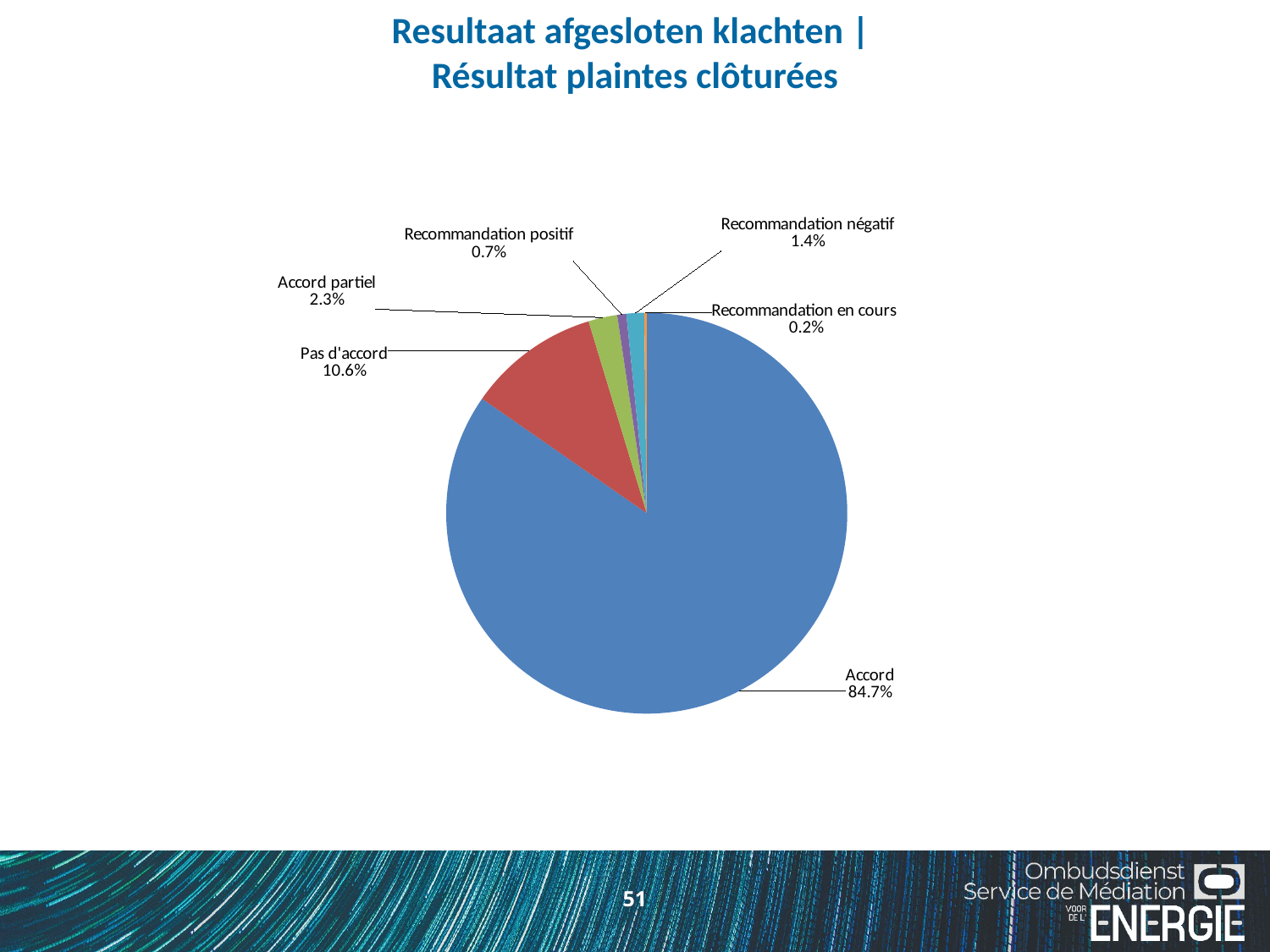
What is the value shown for "Pas d'accord"? 10.6% Which is larger, "Accord partiel" or "Recommandation négatif"? Accord partiel What is the value shown for "Recommandation négatif"? 1.4% How many categories are shown in the pie chart? 6 Which category has the smallest slice of the pie? Recommandation en cours What share of the pie does "Accord" represent? 84.7% What is the value shown for "Accord partiel"? 2.3% What is the value shown for "Recommandation en cours"? 0.2% What is the value shown for "Recommandation positif"? 0.7% What kind of chart is shown on the slide? pie chart What is the difference between the values for "Accord" and "Pas d'accord"? 74.1% Which category has the largest slice of the pie? Accord